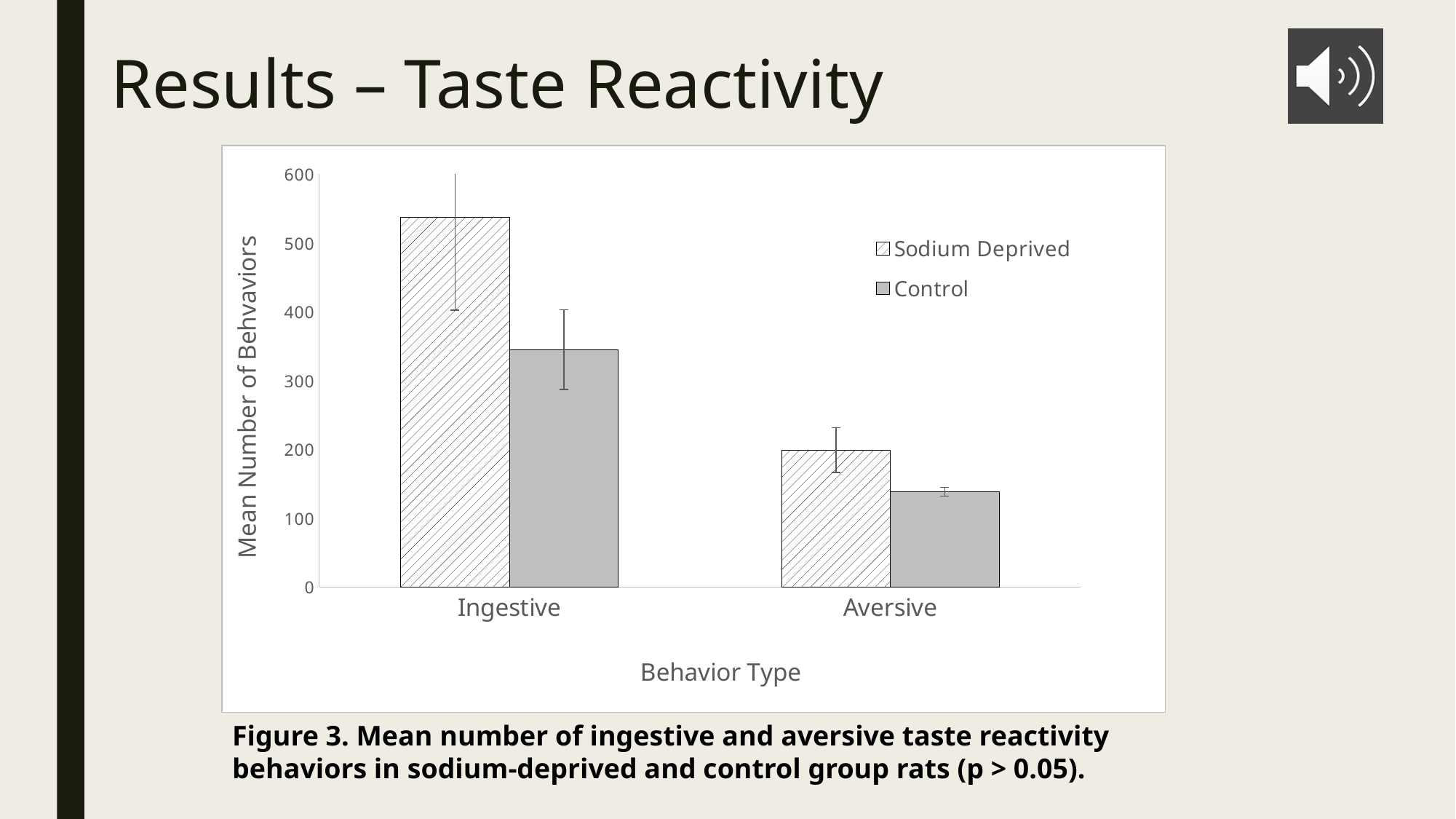
For the Aversive behavior type, which group has the larger value, Sodium Deprived or Control? Sodium Deprived What kind of chart is shown on the slide? bar chart What is the label of the y axis? Mean Number of Behvaviors Which bar is the highest in the chart? Sodium Deprived, Ingestive How many series does the legend list? 2 Is the Sodium Deprived value for Aversive greater or less than 300? less Is the Control value for Ingestive greater or less than 400? less Is the Sodium Deprived value for Ingestive greater or less than 500? greater How many behavior type categories are shown on the x axis? 2 Which bar is the lowest in the chart? Control, Aversive